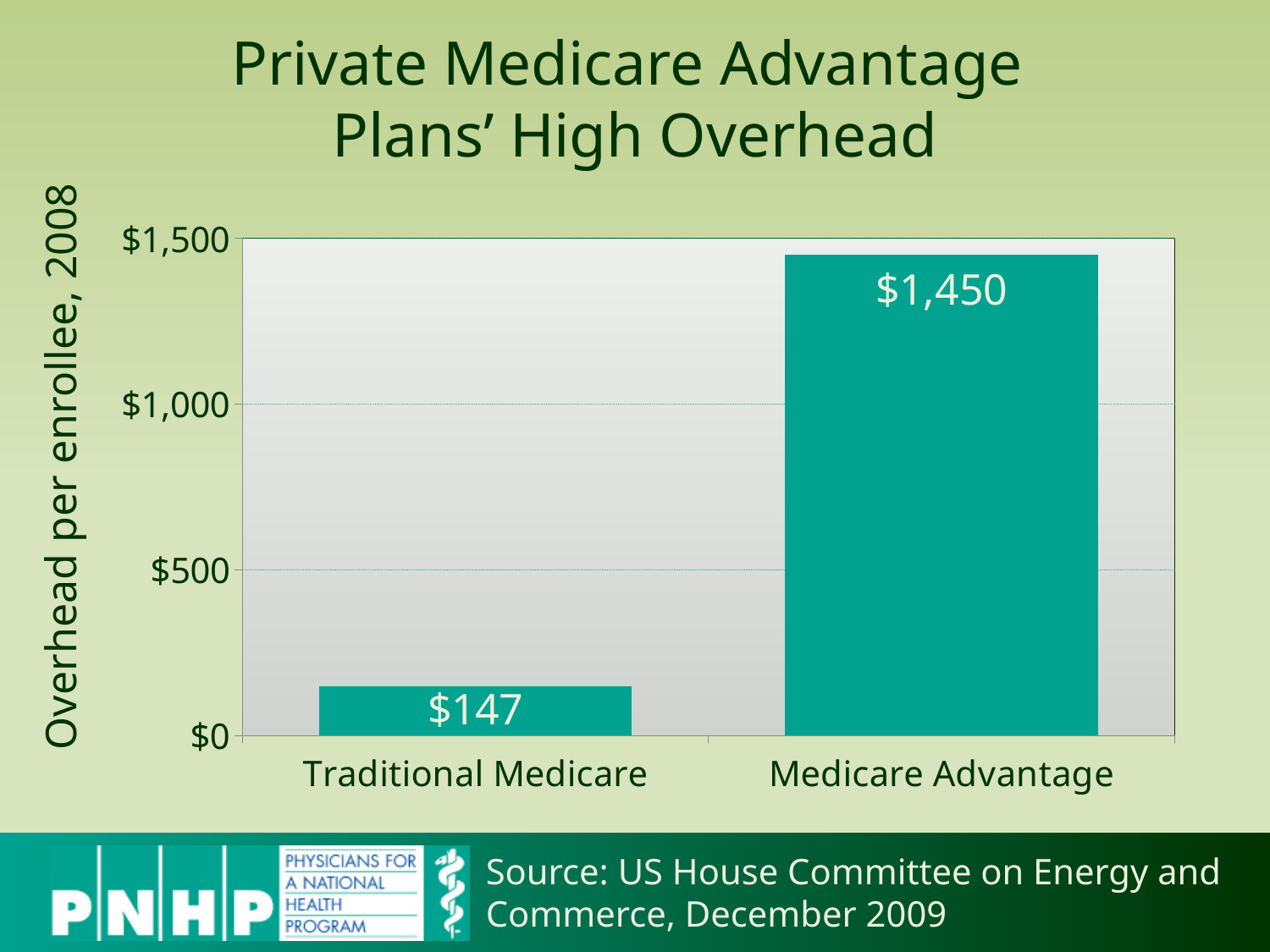
Is the value for Traditional Medicare greater or less than $500? less What is the difference in overhead per enrollee between Medicare Advantage and Traditional Medicare? $1,303 Which category has the lowest overhead per enrollee? Traditional Medicare Which category has the highest overhead per enrollee? Medicare Advantage Which has a larger overhead per enrollee, Traditional Medicare or Medicare Advantage? Medicare Advantage What is the title of the chart on the slide? Private Medicare Advantage Plans' High Overhead What is the overhead per enrollee for Medicare Advantage? $1,450 What kind of chart is shown on the slide? bar chart What is the label on the vertical axis of the chart? Overhead per enrollee, 2008 What is the overhead per enrollee for Traditional Medicare? $147 Is the value for Medicare Advantage greater or less than $1,000? greater How many categories are shown in the chart? 2